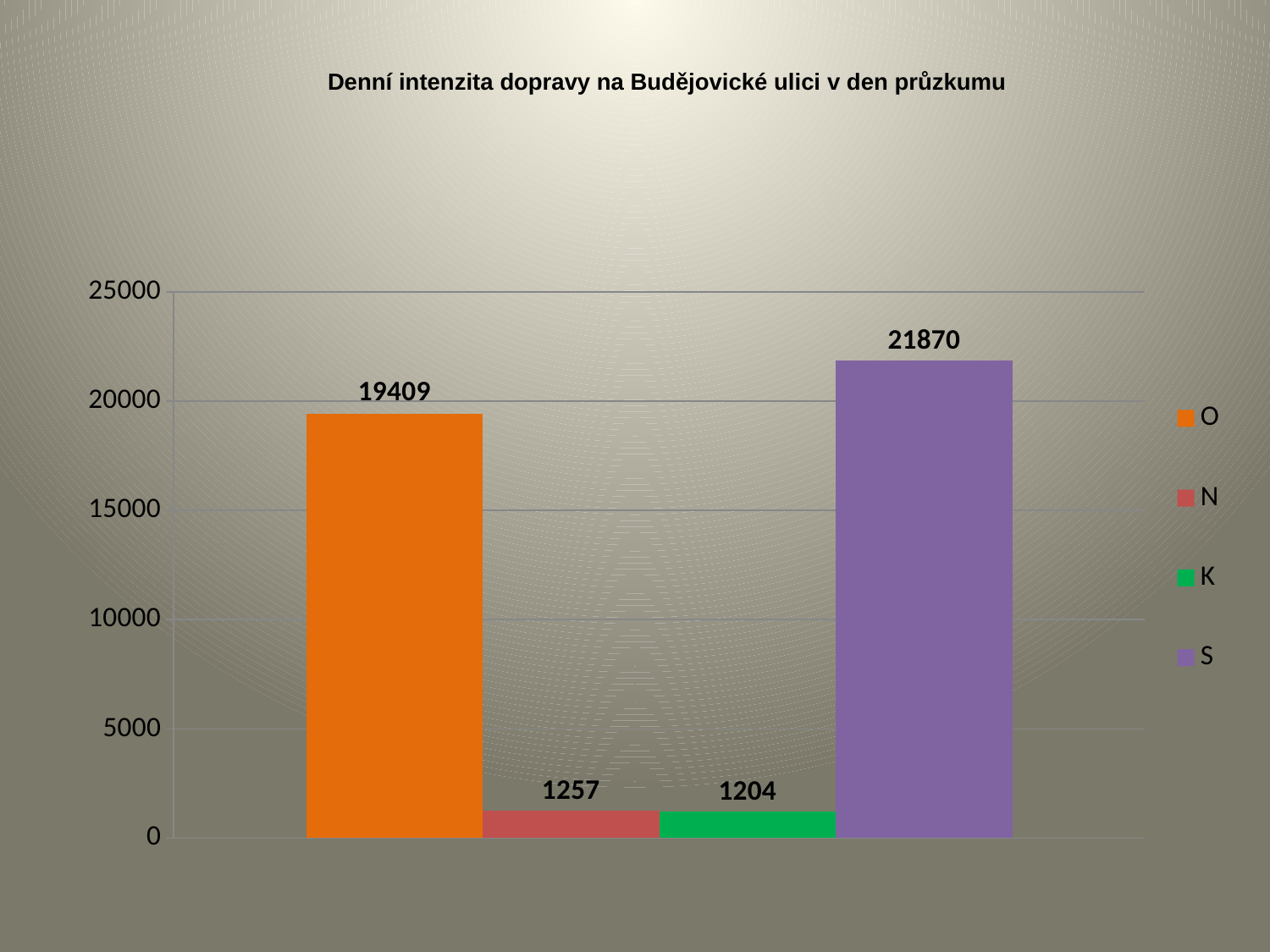
What is the value for S? 21870 What is the difference between the values for S and O? 2461 What is the difference between the values for N and K? 53 Which series has the lowest value? K Is the value for O greater or less than 20000? less Which is larger, the value for O or the value for S? S What is the value for O? 19409 What is the value for N? 1257 What kind of chart is shown on the slide? bar chart What is the value for K? 1204 How many series does the legend list? 4 Which series has the highest value? S